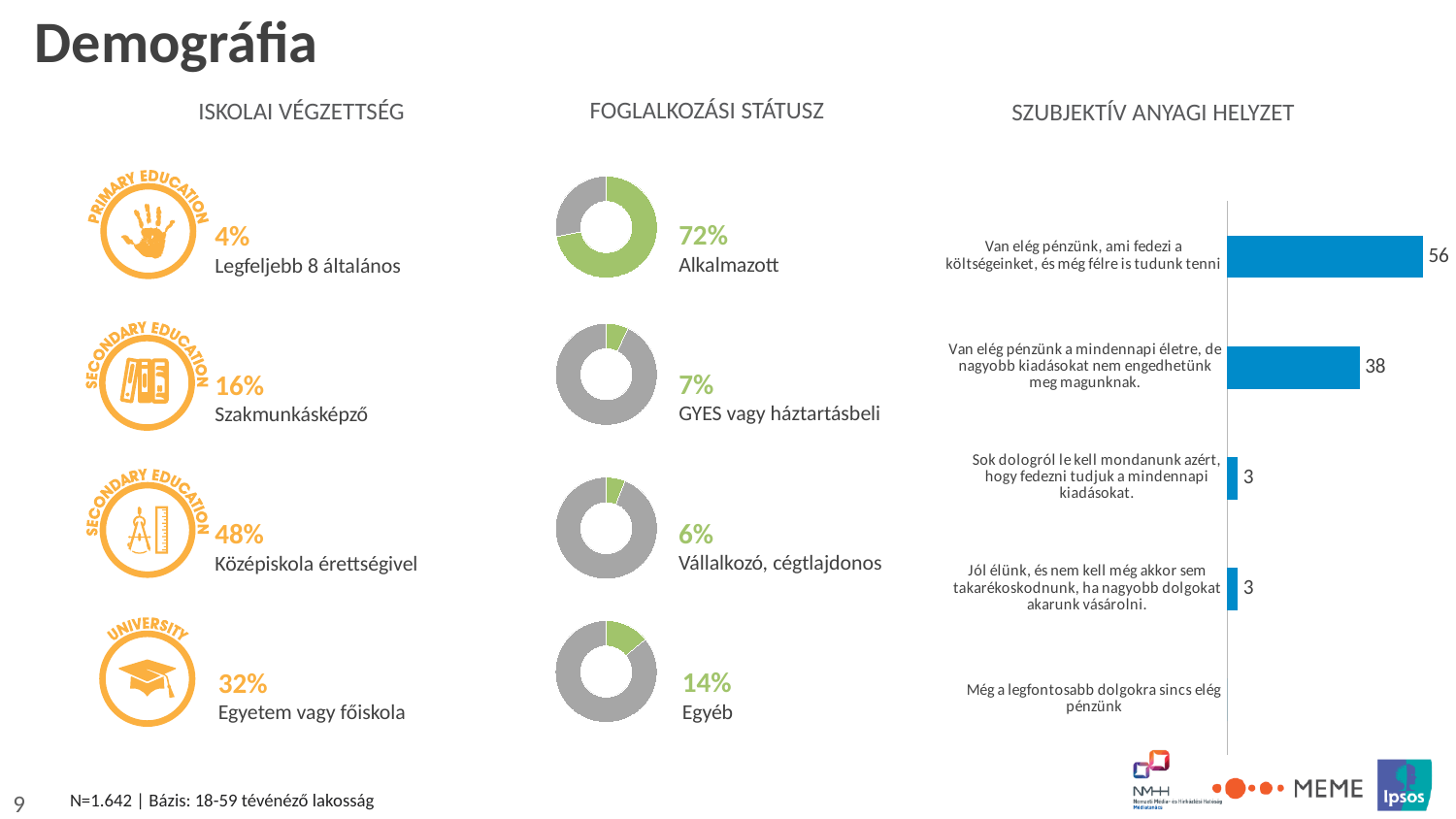
In the SZUBJEKTÍV ANYAGI HELYZET chart, what is the value for "Van elég pénzünk a mindennapi életre, de nagyobb kiadásokat nem engedhetünk meg magunknak"? 38 In the FOGLALKOZÁSI STÁTUSZ section, what percentage is shown for Egyéb? 14% In the SZUBJEKTÍV ANYAGI HELYZET chart, which is larger: the value for "Van elég pénzünk a mindennapi életre..." or the value for "Jól élünk, és nem kell még akkor sem takarékoskodnunk..."? Van elég pénzünk a mindennapi életre... In the FOGLALKOZÁSI STÁTUSZ section, what percentage is shown for Alkalmazott? 72% In the SZUBJEKTÍV ANYAGI HELYZET chart, what is the value for "Van elég pénzünk, ami fedezi a költségeinket, és még félre is tudunk tenni"? 56 How many categories are listed in the SZUBJEKTÍV ANYAGI HELYZET chart? 5 In the SZUBJEKTÍV ANYAGI HELYZET chart, what is the difference between the two largest values, 56 and 38? 18 In the SZUBJEKTÍV ANYAGI HELYZET chart, what is the value for "Sok dologról le kell mondanunk azért, hogy fedezni tudjuk a mindennapi kiadásokat"? 3 What kind of chart is the SZUBJEKTÍV ANYAGI HELYZET chart? Bar chart What kind of charts are used in the FOGLALKOZÁSI STÁTUSZ section? Donut (pie) charts In the SZUBJEKTÍV ANYAGI HELYZET chart, which category has the highest value? Van elég pénzünk, ami fedezi a költségeinket, és még félre is tudunk tenni In the FOGLALKOZÁSI STÁTUSZ section, which category has the lowest percentage? Vállalkozó, cégtlajdonos